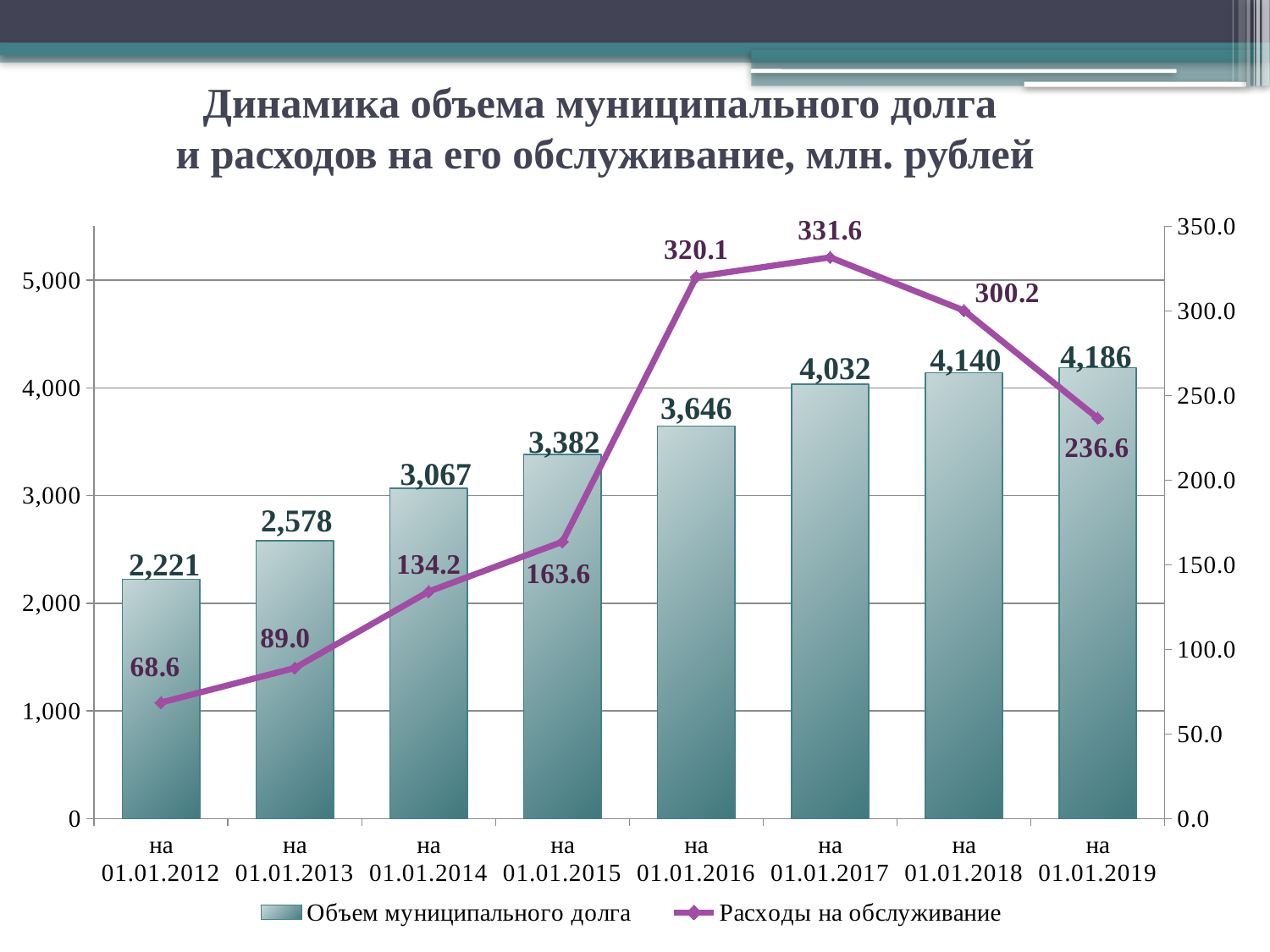
How many dates are shown on the x axis? 8 On which date is Объем муниципального долга the highest? на 01.01.2019 What is the value of Расходы на обслуживание на 01.01.2017? 331.6 On which date is Расходы на обслуживание the lowest? на 01.01.2012 What is the difference in Объем муниципального долга between 01.01.2019 and 01.01.2012? 1,965 Does Объем муниципального долга rise or fall from 01.01.2012 to 01.01.2019? rise What is the difference in Расходы на обслуживание between 01.01.2016 and 01.01.2015? 156.5 How many series does the legend list? 2 What is the value of Объем муниципального долга на 01.01.2015? 3,382 Which is larger: Расходы на обслуживание на 01.01.2018 or на 01.01.2019? на 01.01.2018 On which date is Расходы на обслуживание the highest? на 01.01.2017 What is the value of Расходы на обслуживание на 01.01.2012? 68.6